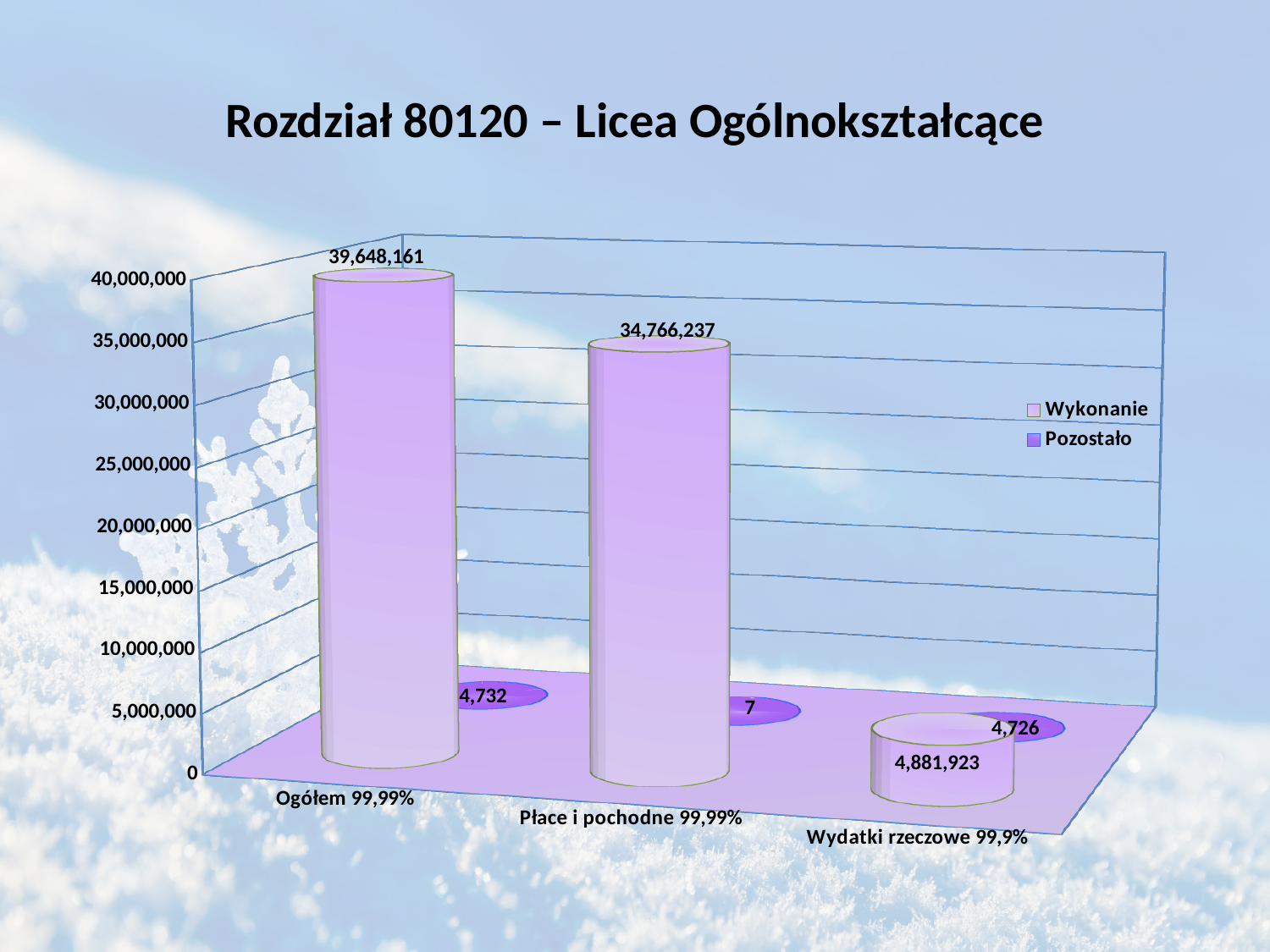
How many series does the legend list? 2 What is the Wykonanie value for Ogółem 99,99%? 39,648,161 What is the difference between the Wykonanie values for Ogółem 99,99% and Płace i pochodne 99,99%? 4,881,924 What is the title of the chart? Rozdział 80120 – Licea Ogólnokształcące What is the Pozostało value for Płace i pochodne 99,99%? 7 Is the Wykonanie value for Wydatki rzeczowe 99,9% greater or less than 5,000,000? less What is the Wykonanie value for Wydatki rzeczowe 99,9%? 4,881,923 Which category has the lowest Pozostało value? Płace i pochodne 99,99% Which category has the highest Wykonanie value? Ogółem 99,99% What is the Pozostało value for Wydatki rzeczowe 99,9%? 4,726 What is the Pozostało value for Ogółem 99,99%? 4,732 What is the Wykonanie value for Płace i pochodne 99,99%? 34,766,237